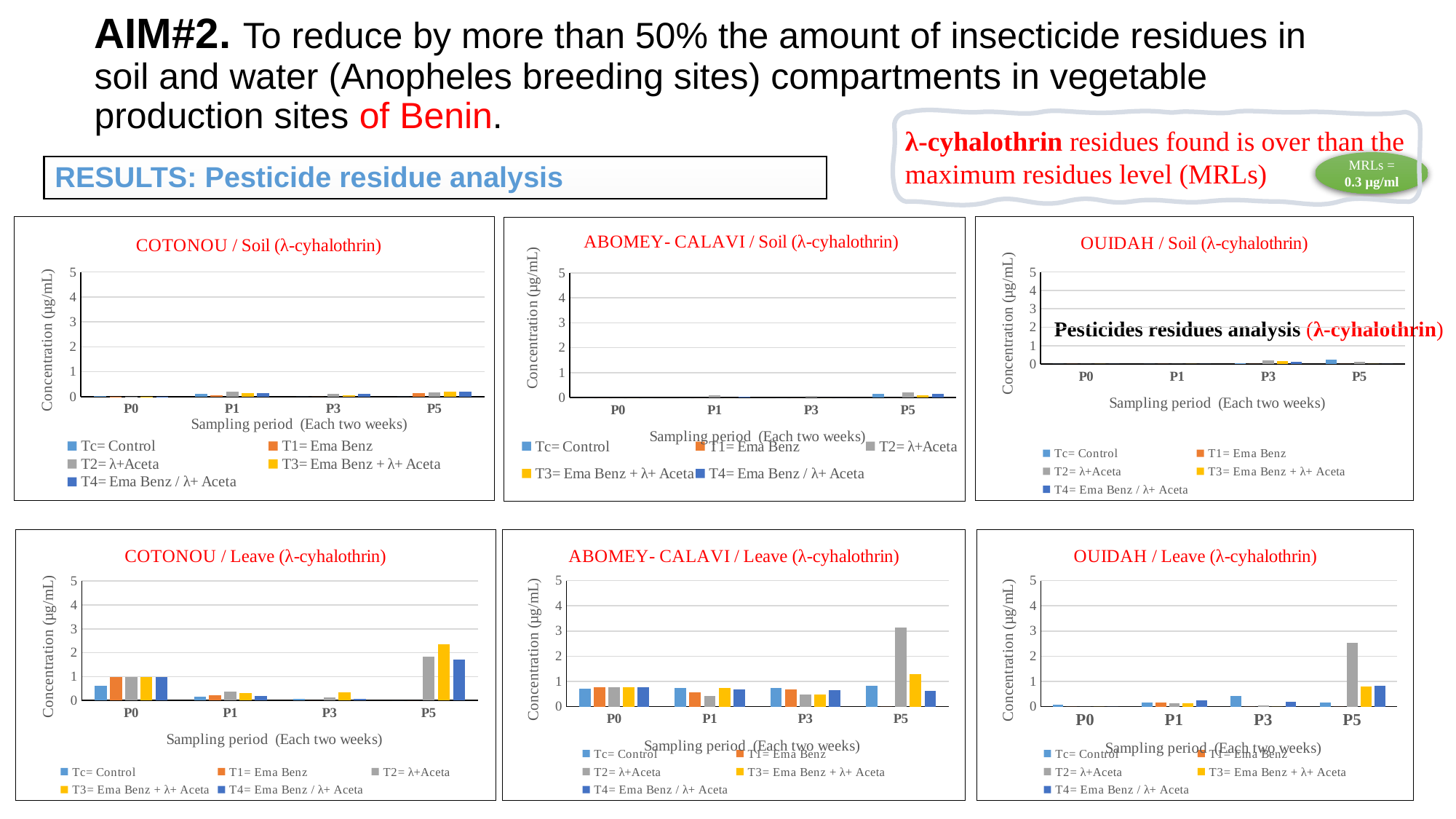
In the COTONOU / Leave (λ-cyhalothrin) chart, which series has the highest value at P5? T3= Ema Benz + λ+ Aceta In the ABOMEY- CALAVI / Leave (λ-cyhalothrin) chart, which is larger at P5: T2= λ+Aceta or T3= Ema Benz + λ+ Aceta? T2= λ+Aceta In the COTONOU / Leave (λ-cyhalothrin) chart, is the value for T2= λ+Aceta larger at P0 or at P5? P5 How many sampling periods are shown on the x axis of the COTONOU / Soil (λ-cyhalothrin) chart? 4 What kind of chart is the COTONOU / Leave (λ-cyhalothrin) chart? bar chart In the ABOMEY- CALAVI / Leave (λ-cyhalothrin) chart, which series has the highest value at P5? T2= λ+Aceta What is the y-axis label of the OUIDAH / Soil (λ-cyhalothrin) chart? Concentration (µg/mL) How many series does the legend of the ABOMEY- CALAVI / Leave (λ-cyhalothrin) chart list? 5 In the ABOMEY- CALAVI / Leave (λ-cyhalothrin) chart, is the value for T2= λ+Aceta at P5 greater or less than 2? greater In the OUIDAH / Leave (λ-cyhalothrin) chart, is the value for T2= λ+Aceta at P5 greater or less than 2? greater In the OUIDAH / Leave (λ-cyhalothrin) chart, which series has the highest value at P5? T2= λ+Aceta In the COTONOU / Leave (λ-cyhalothrin) chart, is the value for T3= Ema Benz + λ+ Aceta at P5 greater or less than 2? greater